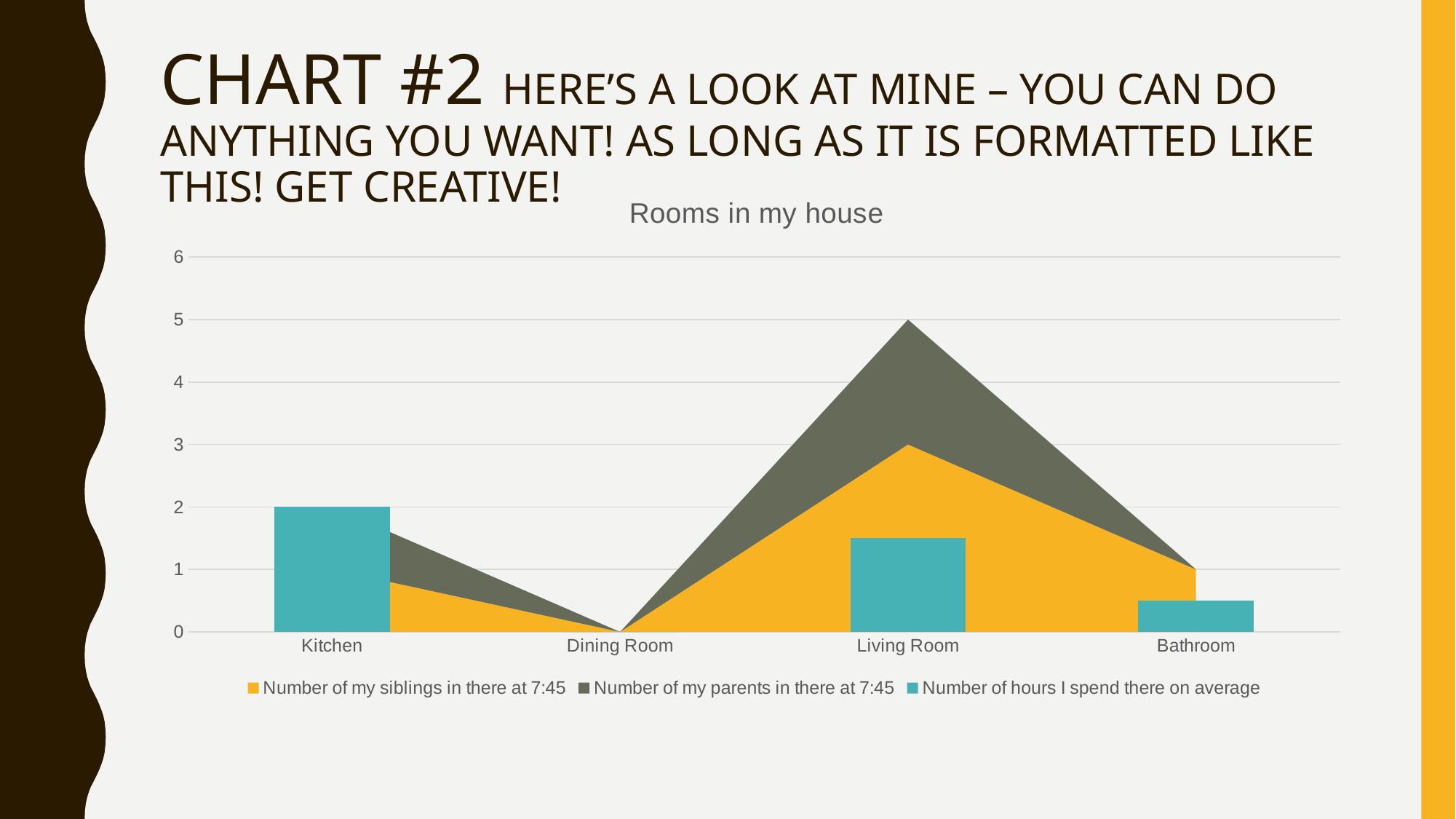
What is the title of the chart? Rooms in my house What kind of chart is used to plot the 'Number of hours I spend there on average' series? bar chart What is the value for Living Room in the 'Number of my siblings in there at 7:45' series? 3 How many rooms (categories) are shown on the x axis? 4 Which room has the highest value for 'Number of my parents in there at 7:45'? Living Room How many series does the legend list? 3 What is the value for Kitchen in the 'Number of hours I spend there on average' series? 2 Which is larger: the 'Number of hours I spend there on average' for Kitchen or for Bathroom? Kitchen What is the value for Living Room in the 'Number of my parents in there at 7:45' series? 2 Which room has the lowest value for 'Number of hours I spend there on average'? Dining Room Is the value for Living Room in the 'Number of hours I spend there on average' series greater or less than 2? less For Living Room, what is the difference between 'Number of my parents in there at 7:45' and 'Number of my siblings in there at 7:45'? 1